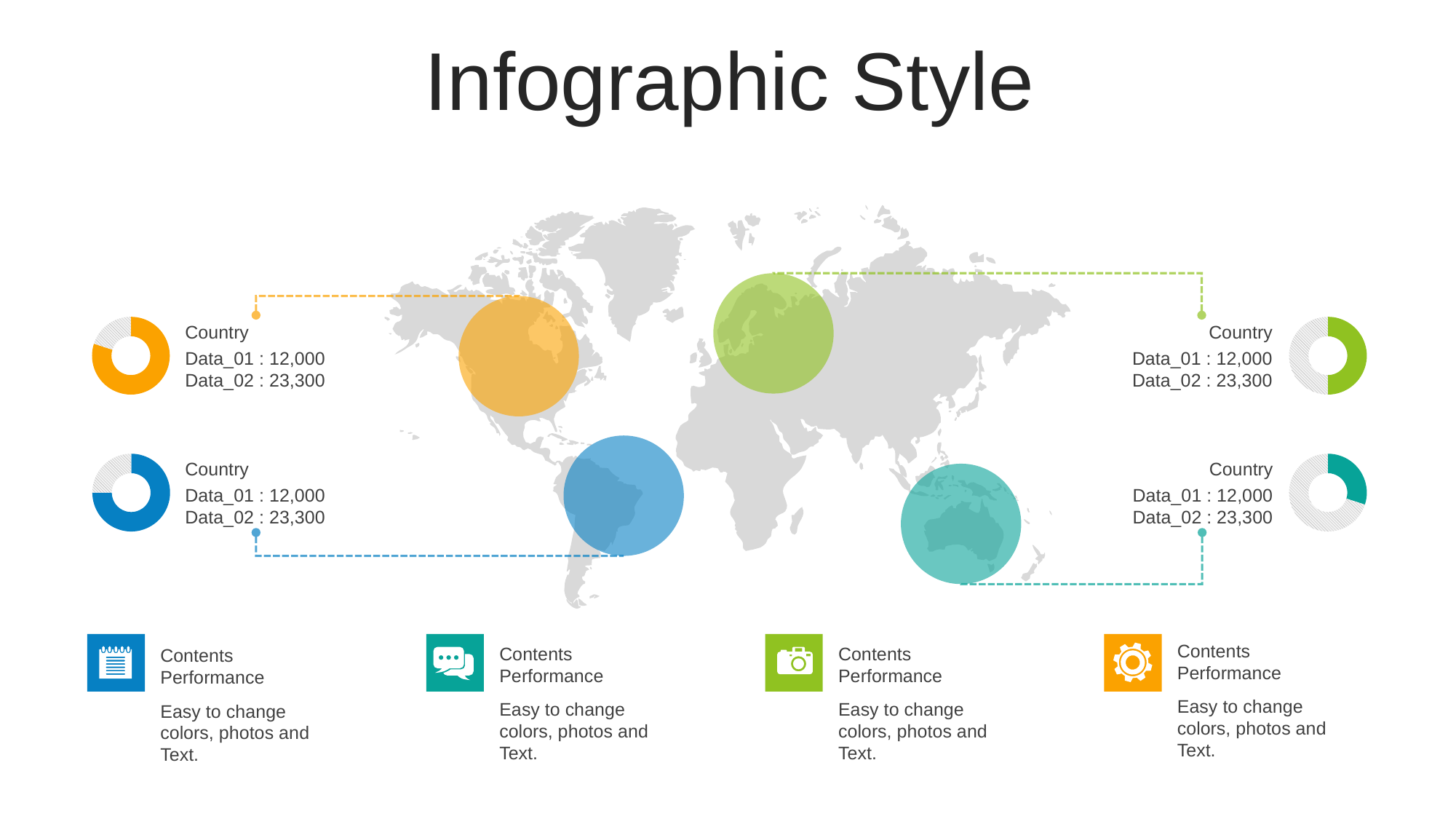
What is the title of the slide containing the donut charts? Infographic Style What kind of chart are the four small charts beside the country labels? Donut (pie) chart For the blue donut chart at the bottom left, what is the difference between Data_02 and Data_01? 11,300 What label appears above the data values next to each donut chart? Country What is the Data_01 value printed next to the teal donut chart at the bottom right? 12,000 Which donut chart has the larger filled portion, the orange one at the top left or the teal one at the bottom right? The orange one How many small donut charts are shown on the slide? 4 What is the Data_02 value printed next to the orange donut chart at the top left? 23,300 What is the Data_02 value printed next to the blue donut chart at the bottom left? 23,300 For the green donut chart at the top right, which is larger, Data_01 or Data_02? Data_02 What is the Data_01 value printed next to the orange donut chart at the top left? 12,000